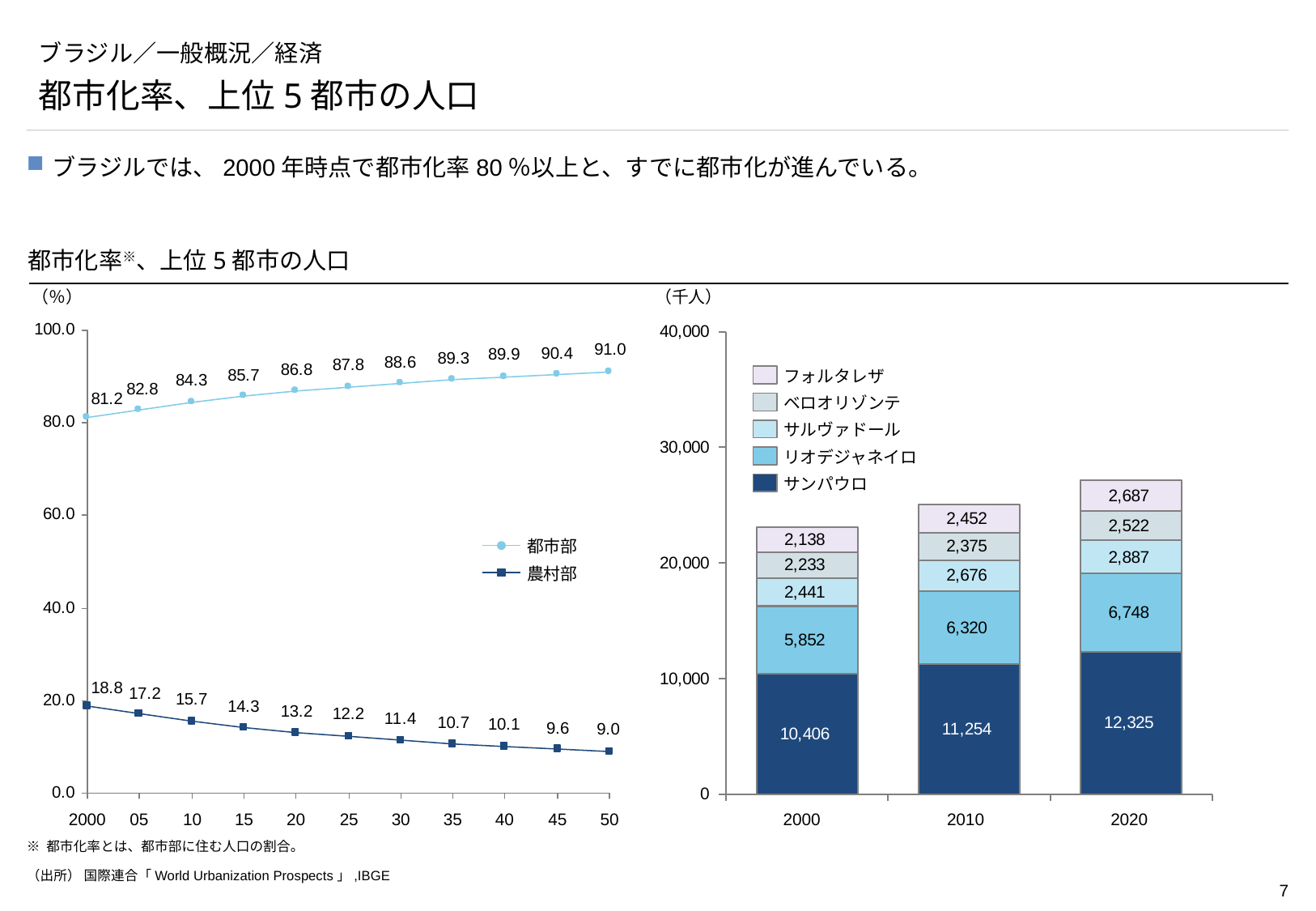
What kind of chart is the right chart? Stacked bar chart In the right chart, what is the difference between the サンパウロ values for 2020 and 2000? 1,919 In the left line chart, how does the 農村部 series change from 2000 to 50? It falls In the left line chart, how many points are plotted for the 都市部 series? 11 In the right chart, what is the total of the stacked bar for 2000? 23,070 In the right chart, which city has the smallest value in 2000? フォルタレザ In the right chart, what is the リオデジャネイロ value for 2010? 6,320 In the left line chart, what is the 農村部 value for 50? 9.0 In the left line chart, what is the 都市部 value for 2000? 81.2 In the left line chart, how many series does the legend list? 2 In the right chart, what is the サンパウロ value for 2020? 12,325 In the left line chart, what is the difference between the 都市部 and 農村部 values for 2000? 62.4